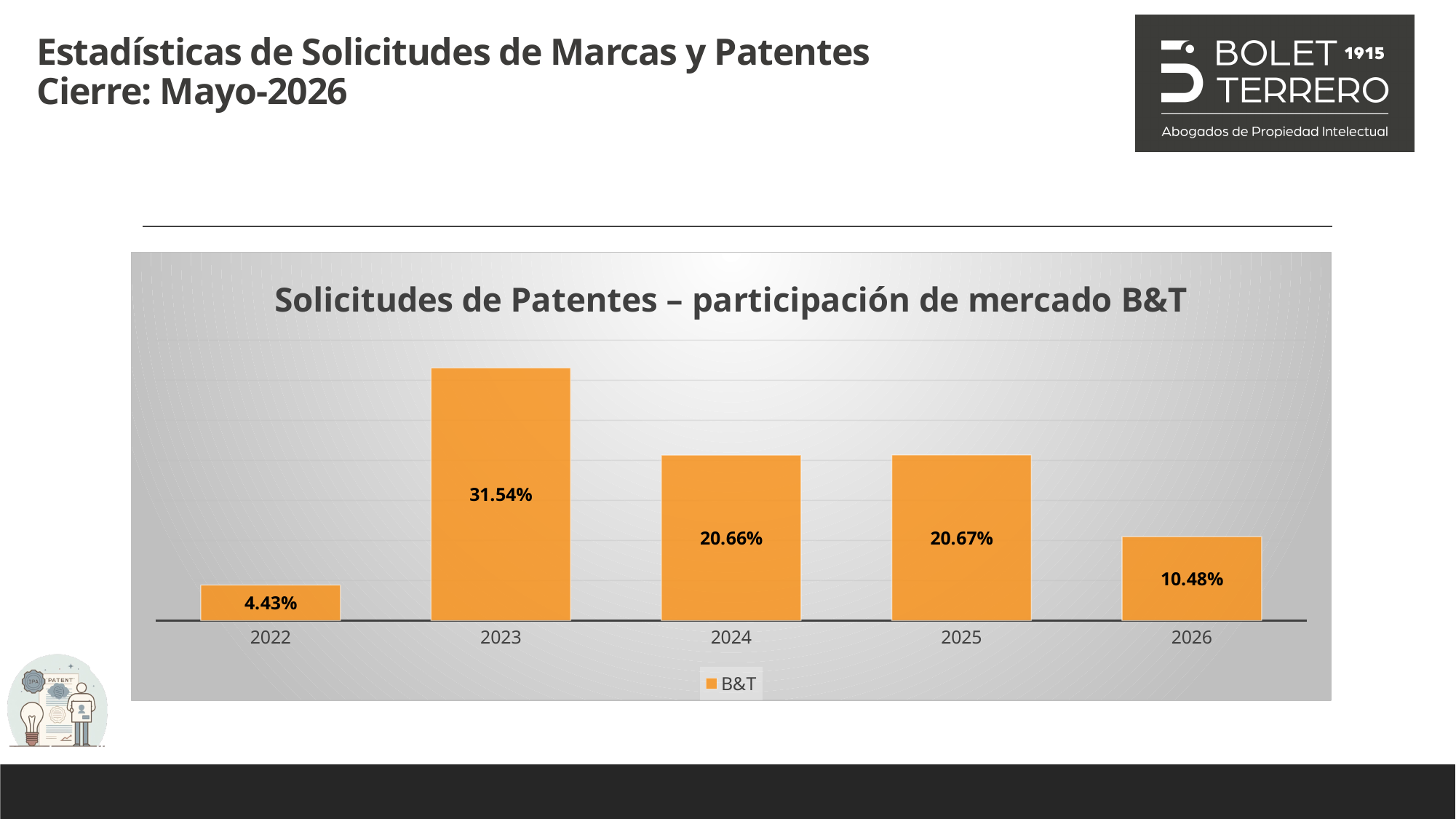
What is the B&T market share for 2024? 20.66% What is the difference between the B&T market share in 2023 and in 2022? 27.11% Which year has the lowest B&T market share? 2022 Which year has the highest B&T market share? 2023 What is the B&T market share for 2026? 10.48% Which year has a larger B&T market share, 2026 or 2022? 2026 What is the difference between the B&T market share in 2023 and in 2026? 21.06% What is the B&T market share for 2023? 31.54% How many years are shown on the x axis of the chart? 5 How many series does the chart legend list? 1 What type of chart is shown on the slide? Bar chart What is the B&T market share for 2022? 4.43%